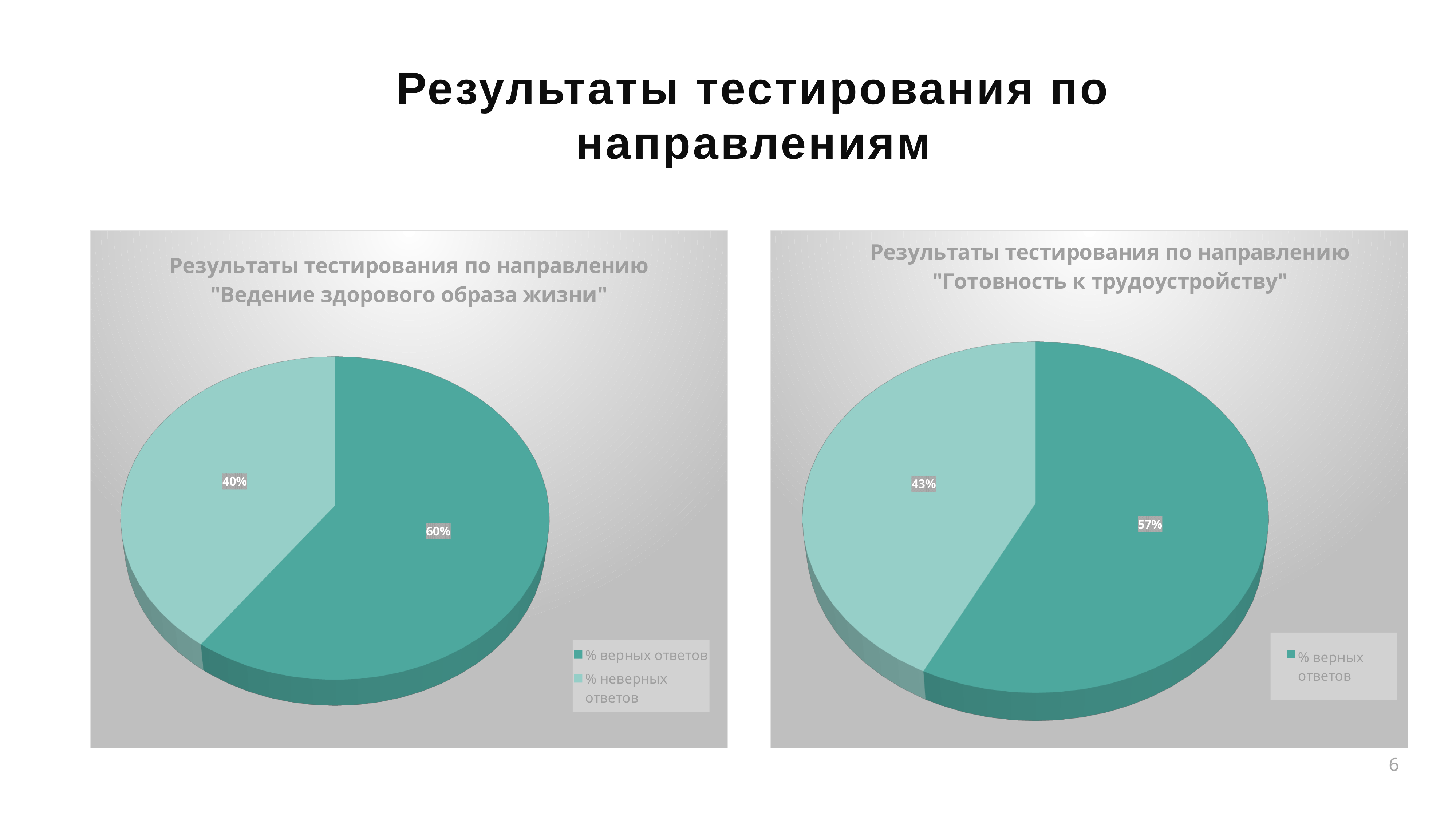
In the right chart ("Готовность к трудоустройству"), what is the value for "% верных ответов"? 57% In the left chart ("Ведение здорового образа жизни"), which slice is the smallest? % неверных ответов How many slices does the left chart ("Ведение здорового образа жизни") have? 2 In the left chart ("Ведение здорового образа жизни"), what is the difference between "% верных ответов" and "% неверных ответов"? 20% In the right chart ("Готовность к трудоустройству"), what value is shown on the lighter slice? 43% In the left chart ("Ведение здорового образа жизни"), which slice is the largest? % верных ответов What type of chart is used on this slide? Pie chart In the right chart ("Готовность к трудоустройству"), what is the difference between the two slices? 14% How many entries does the legend of the left chart ("Ведение здорового образа жизни") list? 2 Which chart has the larger value for "% верных ответов", the left one or the right one? The left one In the left chart ("Ведение здорового образа жизни"), what is the value for "% верных ответов"? 60% In the left chart ("Ведение здорового образа жизни"), what is the value for "% неверных ответов"? 40%